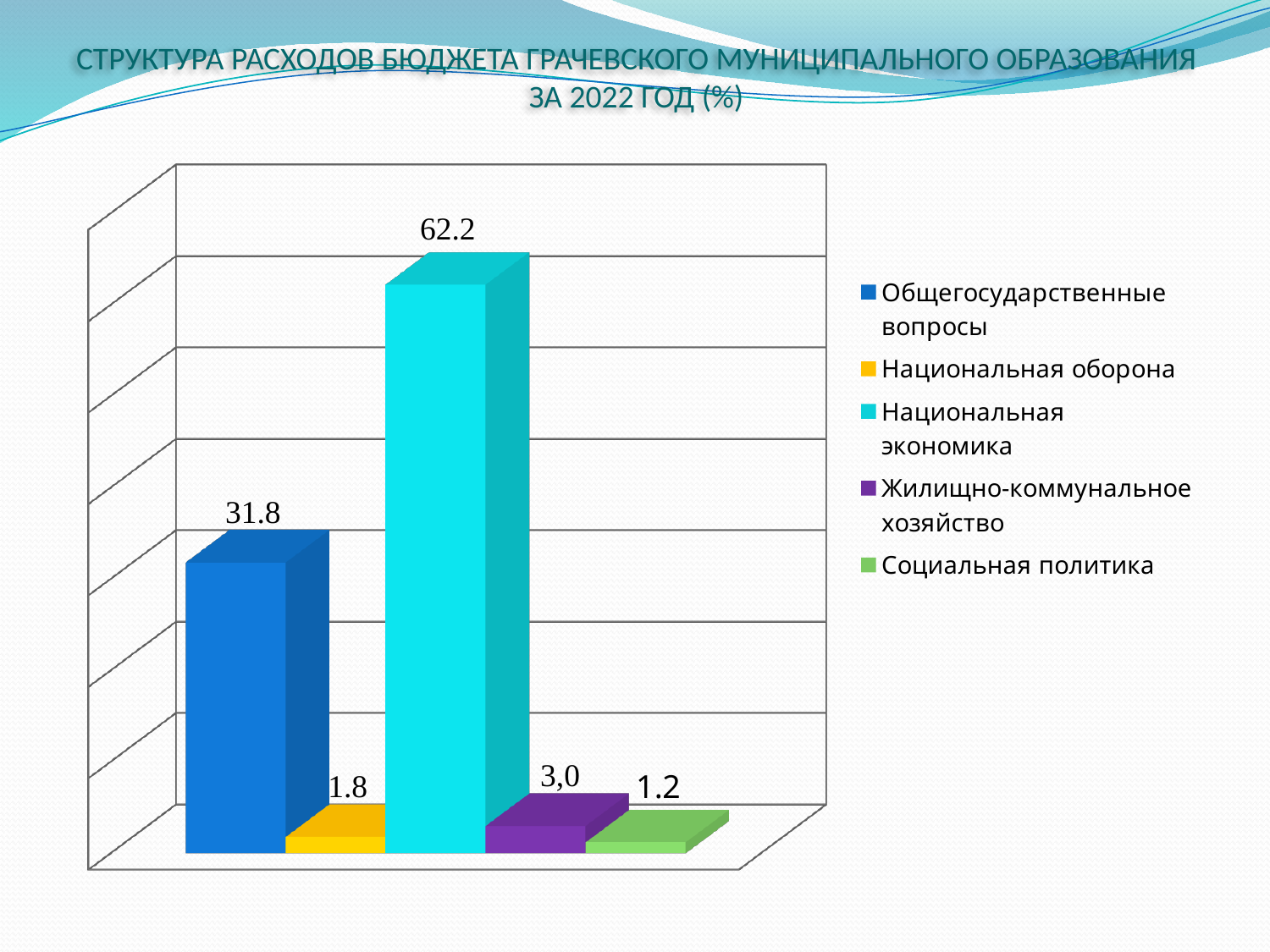
Which category has the lowest value? Социальная политика What is the value for Жилищно-коммунальное хозяйство? 3,0 What is the value for Социальная политика? 1.2 How many entries does the legend list? 5 Which category has the highest value? Национальная экономика What is the value for Общегосударственные вопросы? 31.8 Which is larger, the value for Национальная оборона or the value for Жилищно-коммунальное хозяйство? Жилищно-коммунальное хозяйство What is the value for Национальная оборона? 1.8 What kind of chart is shown on the slide? Bar chart How many bars are plotted in the chart? 5 What is the difference between the values for Национальная экономика and Общегосударственные вопросы? 30.4 What is the value for Национальная экономика? 62.2